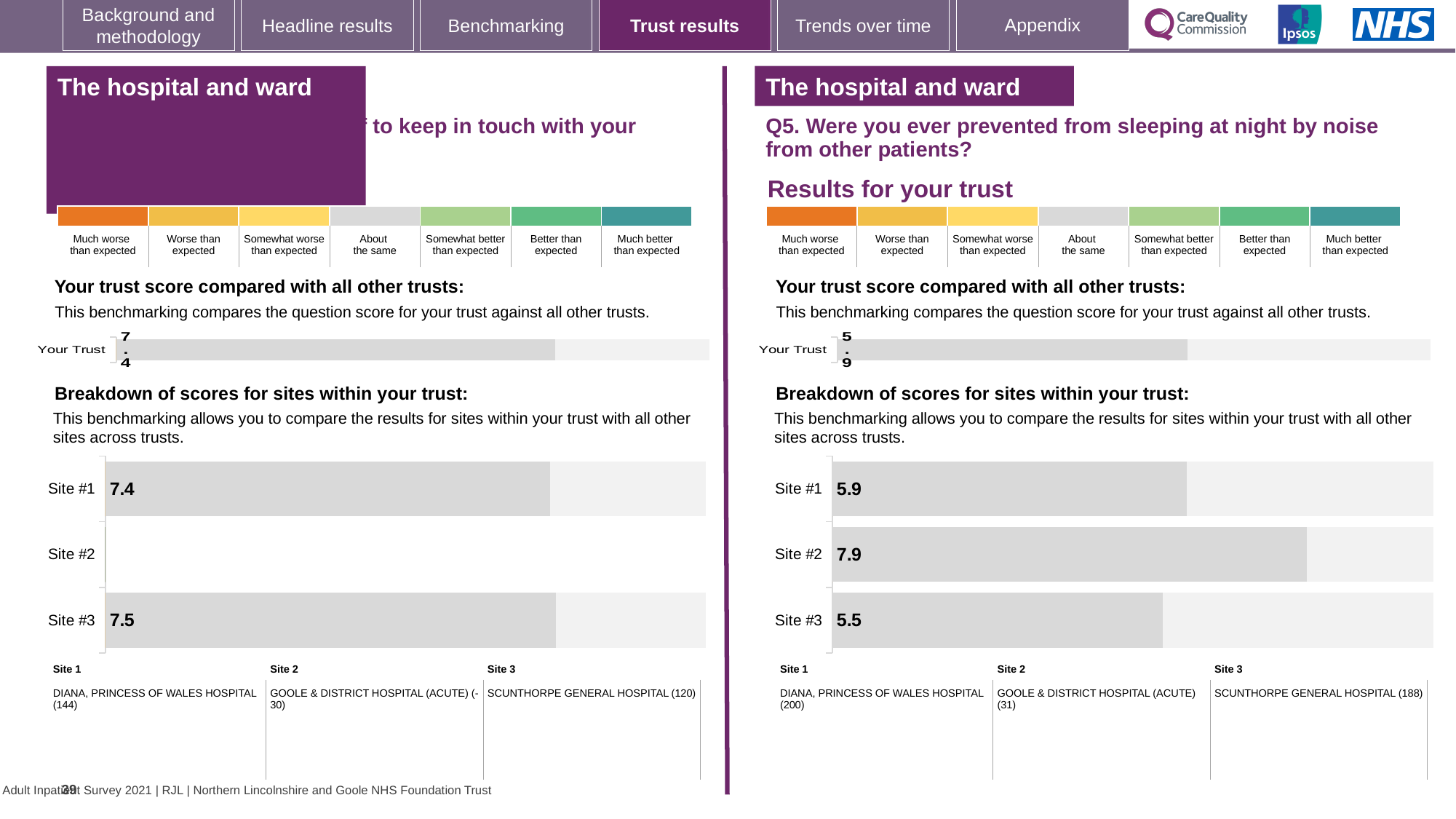
On the right-hand Q5 site breakdown chart, what is the score for Site #2? 7.9 On the right-hand chart for Q5 (prevented from sleeping at night by noise from other patients), what is the trust score shown for 'Your Trust'? 5.9 On the left-hand site breakdown chart, what is the score for Site #3? 7.5 On the left-hand chart, what is the trust score shown for 'Your Trust'? 7.4 On the left-hand site breakdown chart, what is the score for Site #1? 7.4 What kind of chart is used for the site breakdown on the right-hand side of the slide? Bar chart On the right-hand Q5 site breakdown chart, what is the difference between the scores for Site #2 and Site #3? 2.4 On the right-hand Q5 site breakdown chart, which site has the highest score? Site #2 On the right-hand Q5 site breakdown chart, which is larger, the score for Site #1 or Site #2? Site #2 On the right-hand Q5 site breakdown chart, what is the score for Site #3? 5.5 How many sites are listed on the right-hand Q5 site breakdown chart? 3 On the right-hand Q5 site breakdown chart, which site has the lowest score? Site #3